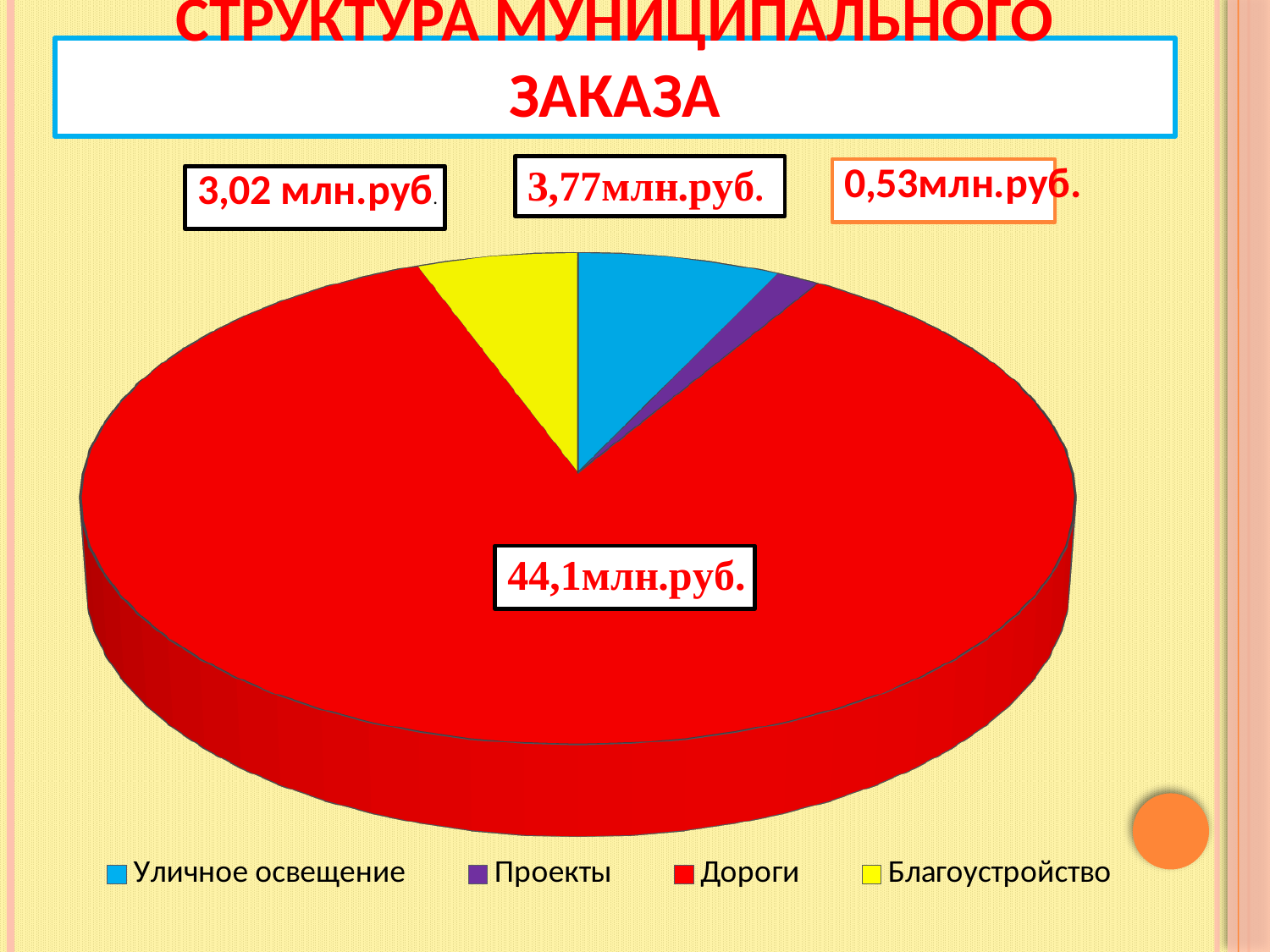
Which slice is larger, Уличное освещение or Проекты? Уличное освещение Which category has the smallest slice of the pie? Проекты What kind of chart is shown on the slide? Pie chart Which category has the largest slice of the pie? Дороги How many slices does the pie chart have? 4 What value is labelled on the Дороги slice? 44,1млн.руб. What colour represents Благоустройство in the legend? Yellow Which slice is larger, Дороги or Благоустройство? Дороги How many entries does the legend list? 4 What is the title of the chart? СТРУКТУРА МУНИЦИПАЛЬНОГО ЗАКАЗА